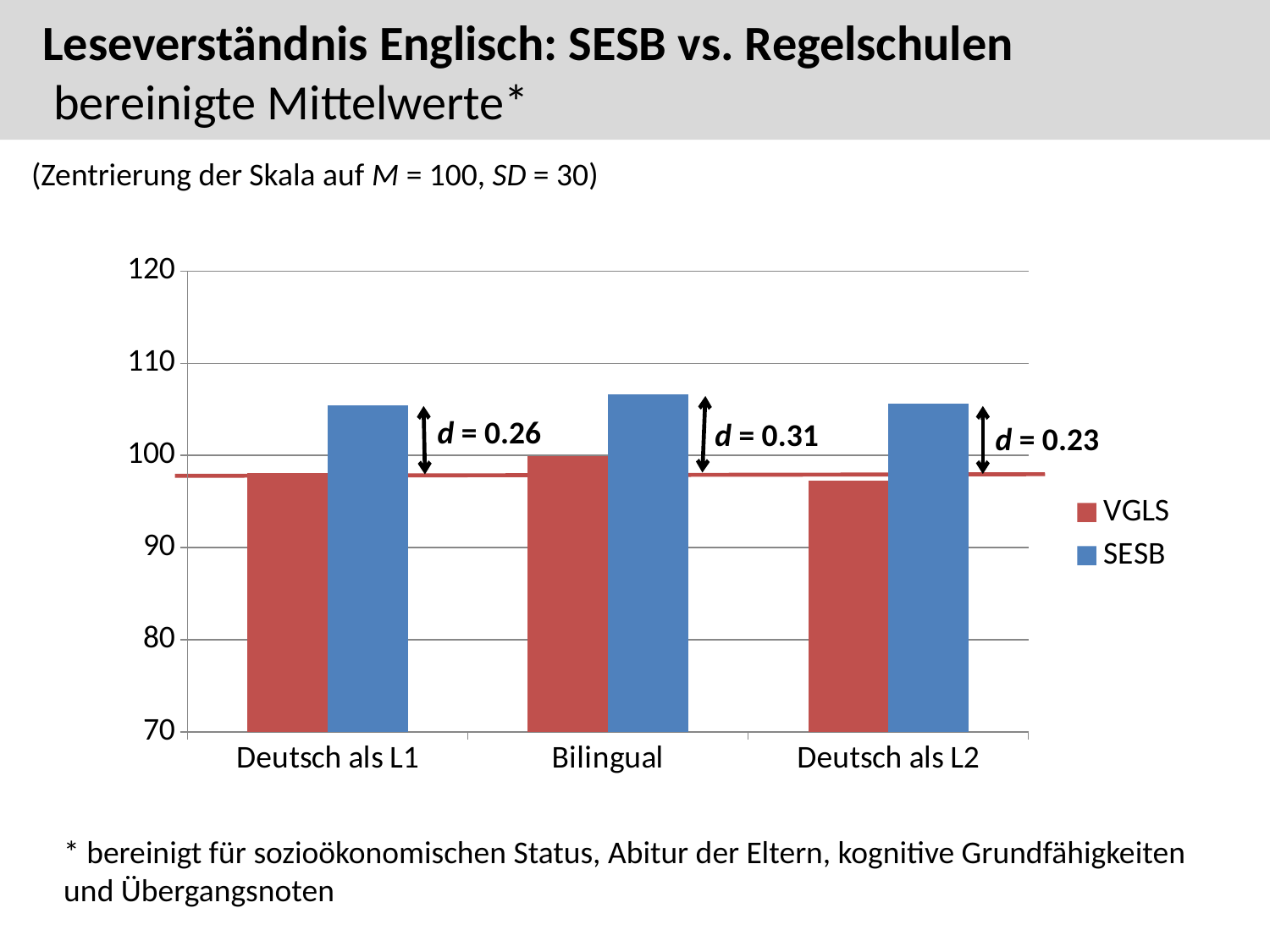
What effect size d is annotated for the Deutsch als L1 category? d = 0.26 For Deutsch als L2, which series has the larger value, VGLS or SESB? SESB Which two series are listed in the chart's legend? VGLS and SESB What effect size d is annotated for the Deutsch als L2 category? d = 0.23 How many series does the chart's legend list? 2 Which category has the largest annotated effect size d? Bilingual What kind of chart is shown on the slide? bar chart What effect size d is annotated for the Bilingual category? d = 0.31 Which category has the smallest annotated effect size d? Deutsch als L2 Is the SESB value for Bilingual greater or less than 110? less How many categories are shown on the x axis of the chart? 3 Is the VGLS value for Deutsch als L2 greater or less than 100? less